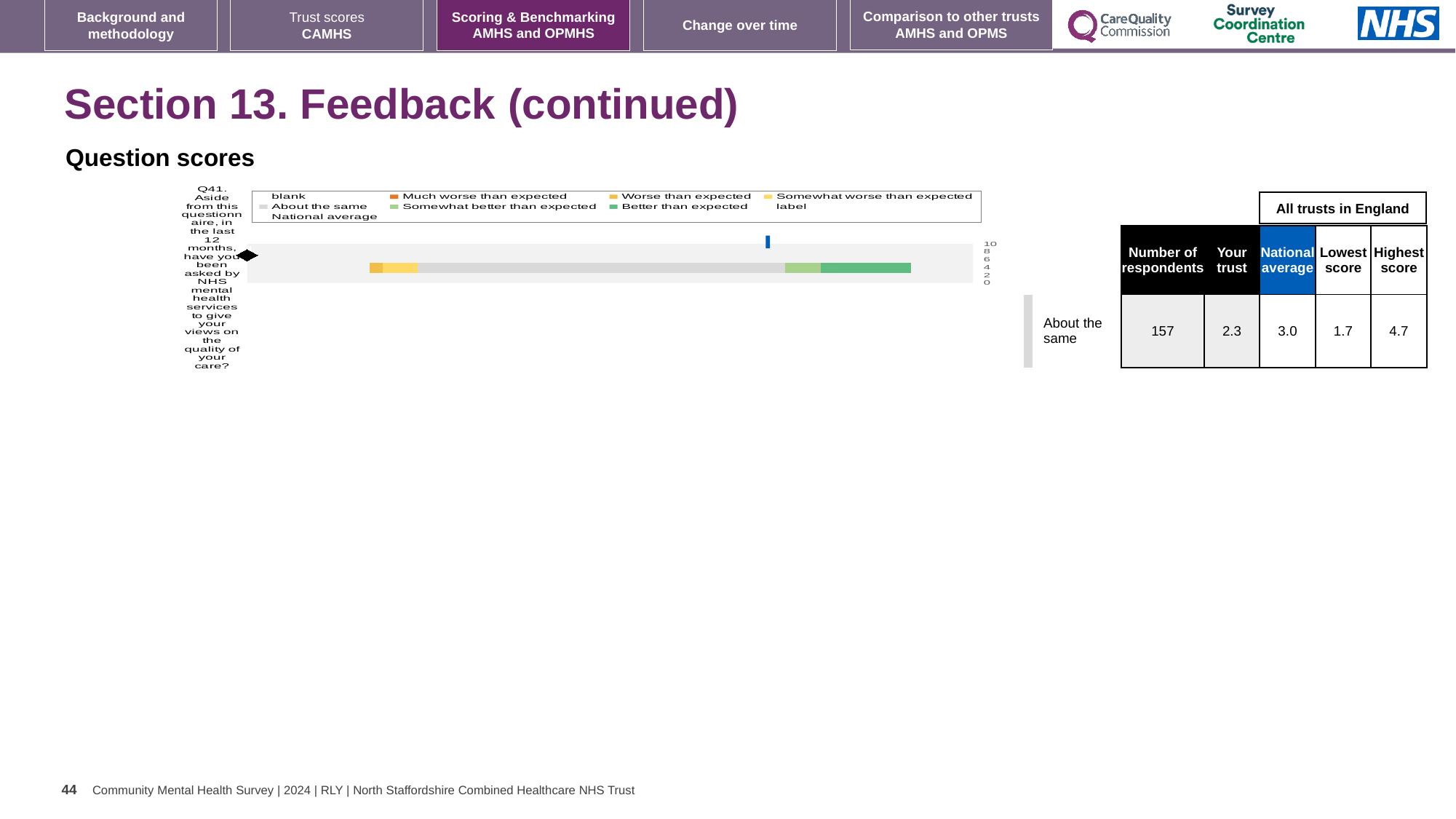
What is the highest value shown on the chart's axis? 10 What kind of chart is shown on the slide? bar chart In the table beside the chart, what is the number of respondents for Q41? 157 How many questions (categories) are plotted in the chart? 1 Which legend entry is shown in dark green? Better than expected What benchmark category is shown for Q41 next to the chart? About the same In the table beside the chart, what is the national average score for Q41? 3.0 Which question number is plotted in the chart? Q41 In the table beside the chart, what is the 'Your trust' score for Q41? 2.3 In the table beside the chart, what is the difference between the highest score and the lowest score for Q41? 3.0 How many entries does the chart legend list? 9 In the table beside the chart, which is larger for Q41: the 'Your trust' score or the national average? National average